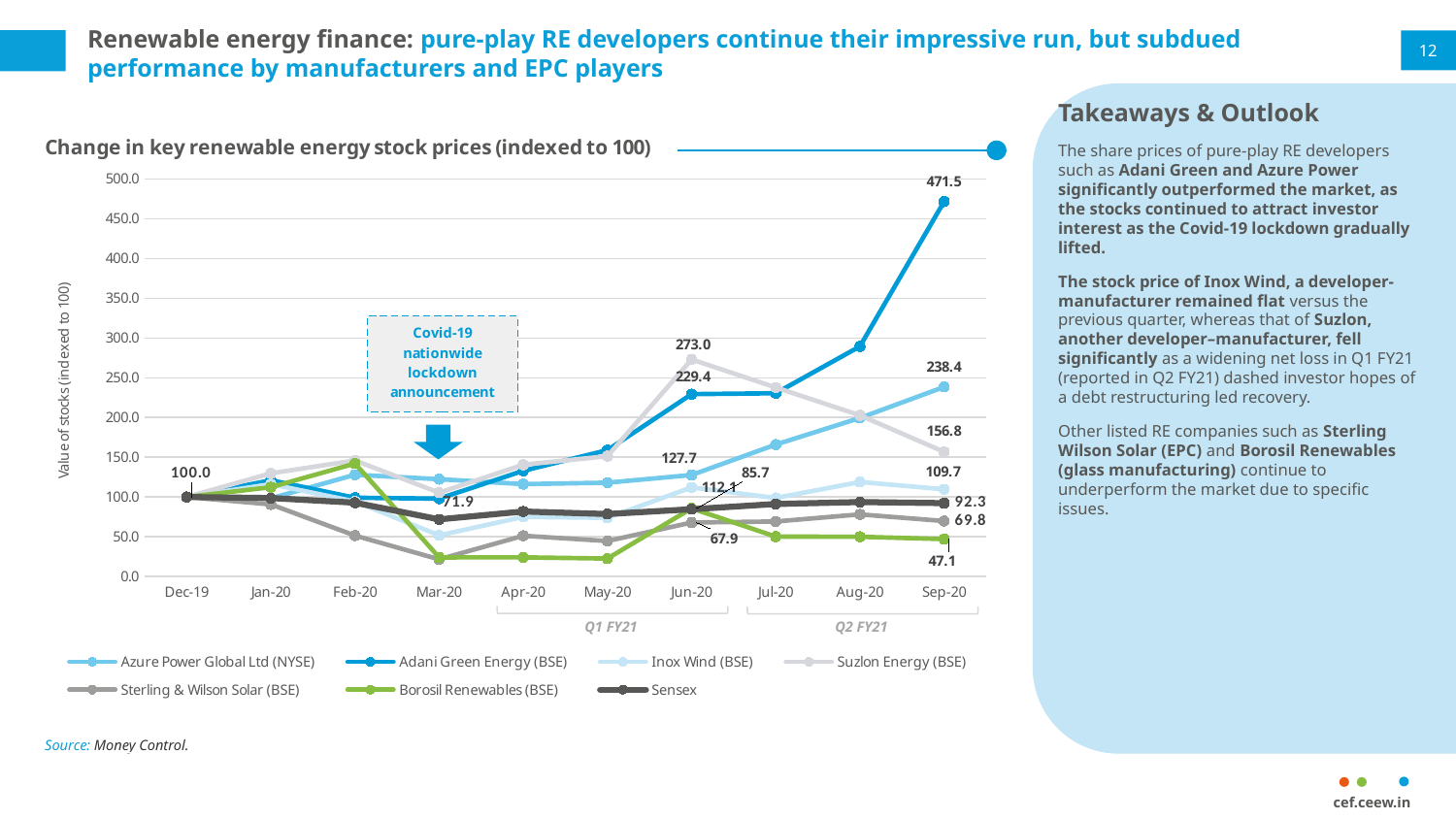
Which series has the highest value in Sep-20? Adani Green Energy (BSE) Which series has the lowest value in Sep-20? Borosil Renewables (BSE) What is the difference between the Sep-20 values of Adani Green Energy (BSE) and Azure Power Global Ltd (NYSE)? 233.1 What is the value of Adani Green Energy (BSE) in Sep-20? 471.5 How many series does the legend list? 7 What is the value of Suzlon Energy (BSE) in Jun-20? 273.0 Is the value for Adani Green Energy (BSE) in Aug-20 greater or less than 250.0? greater What is the value of Azure Power Global Ltd (NYSE) in Sep-20? 238.4 What kind of chart is shown on the slide? Line chart How many months are shown on the x axis? 10 Which is larger in Sep-20: Azure Power Global Ltd (NYSE) or Suzlon Energy (BSE)? Azure Power Global Ltd (NYSE) What is the value of Borosil Renewables (BSE) in Sep-20? 47.1